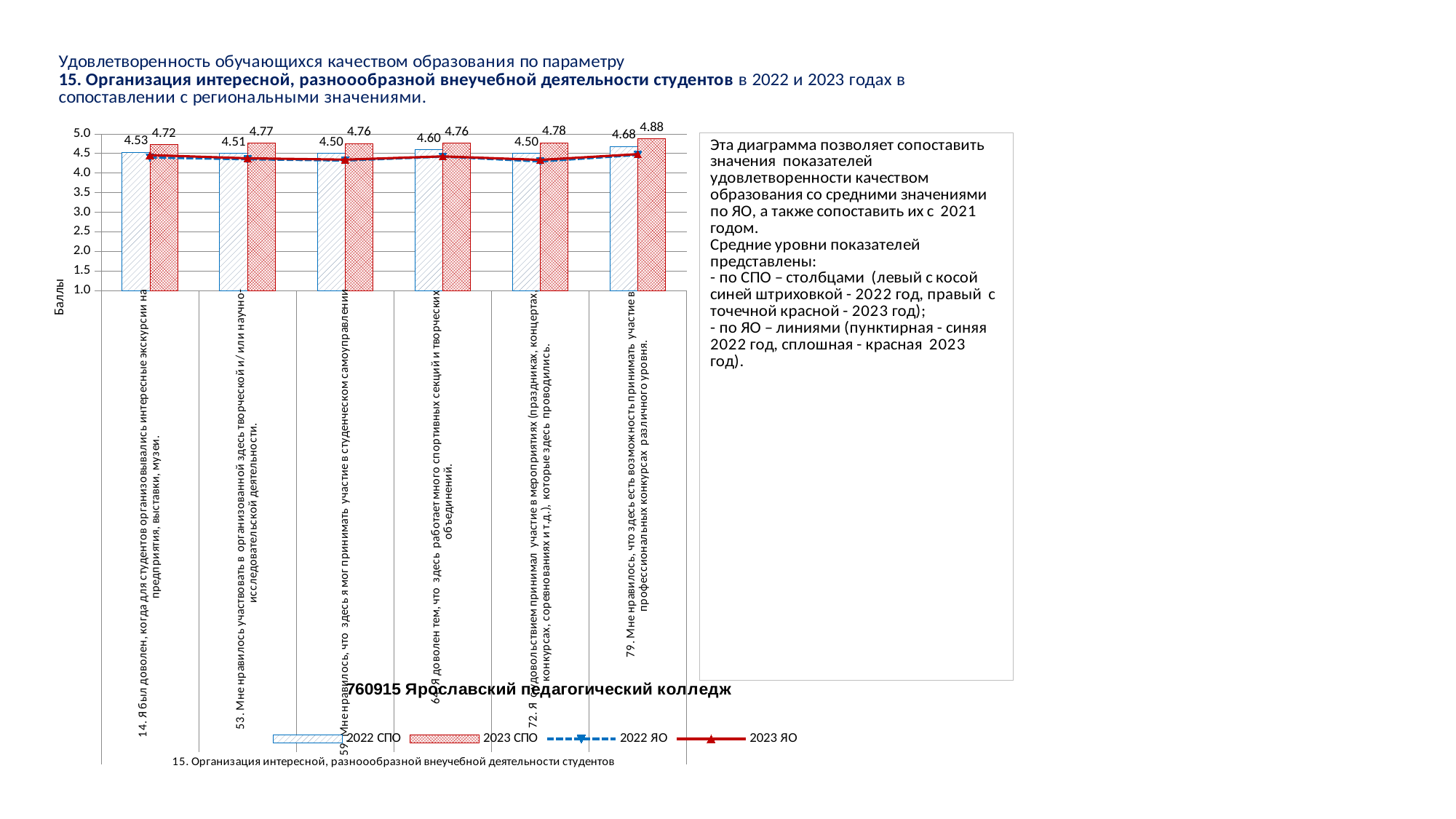
What is the 2022 СПО value for item 53 (participation in creative and/or research activity)? 4.51 What kind of chart is shown on the slide? A combined bar and line chart What is the 2023 СПО value for item 72 (participation in events such as holidays, concerts, competitions)? 4.78 By how much did the СПО value for item 79 increase from 2022 to 2023? 0.20 Which item has the highest 2023 СПО value? 79. Мне нравилось, что здесь есть возможность принимать участие в профессиональных конкурсах различного уровня (4.88) How many series does the legend list? 4 Which item has the highest 2022 СПО value? 79. Мне нравилось, что здесь есть возможность принимать участие в профессиональных конкурсах различного уровня (4.68) Is the 2023 ЯО line value for item 14 greater or less than 4.0? greater What is the 2023 СПО value for item 79 (participation in professional competitions of various levels)? 4.88 What is the 2022 СПО value for item 14 (interesting excursions to enterprises, exhibitions, museums)? 4.53 What is the difference between the 2023 СПО and 2022 СПО values for item 53? 0.26 For item 14, which is larger: the 2022 СПО value or the 2023 СПО value? 2023 СПО (4.72)